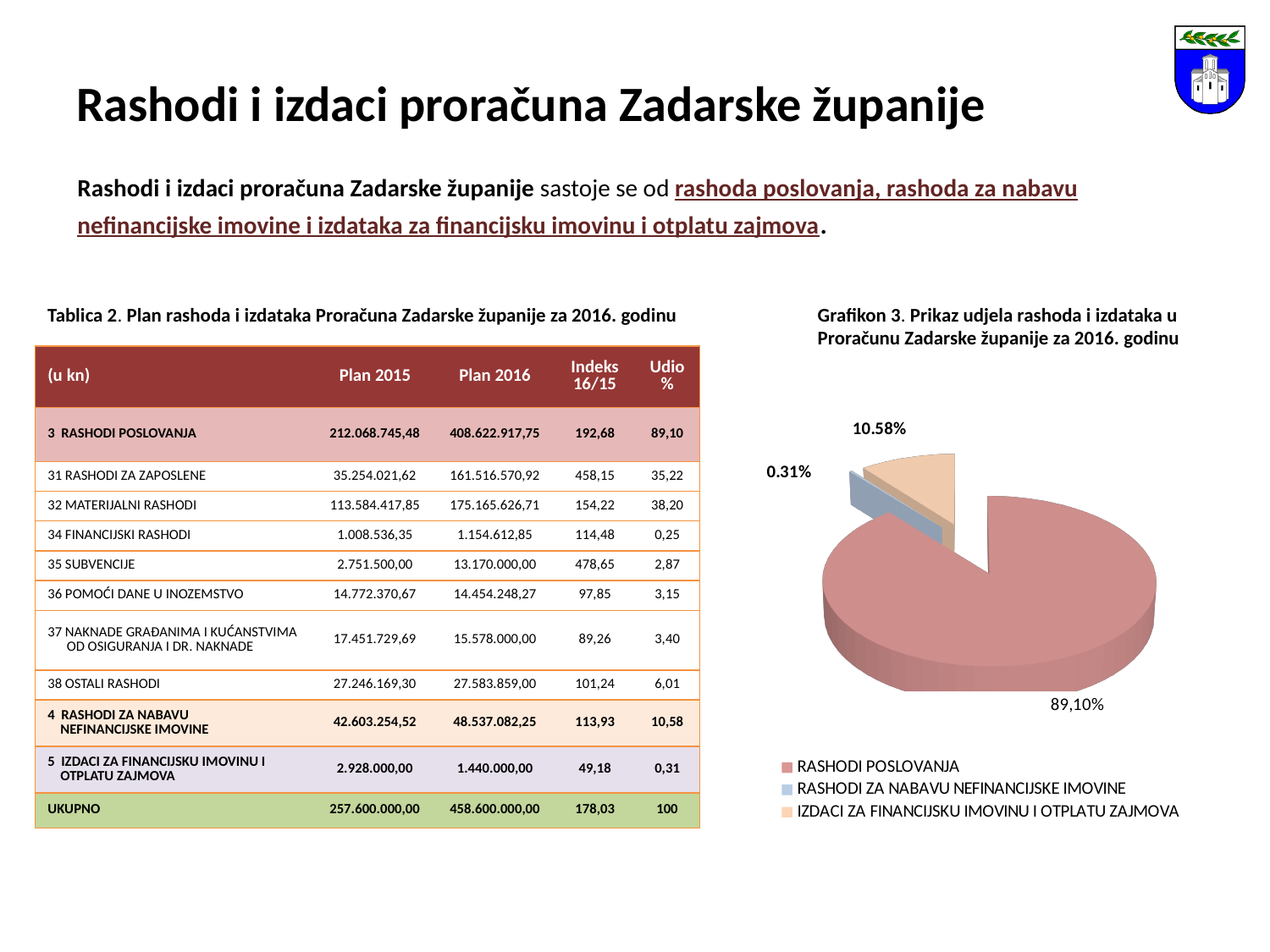
What is the largest percentage label shown on the pie chart in Grafikon 3? 89,10% How many entries does the legend of Grafikon 3 list? 3 Which category has the largest slice in Grafikon 3? RASHODI POSLOVANJA What is the title of the pie chart on the slide? Grafikon 3. Prikaz udjela rashoda i izdataka u Proračunu Zadarske županije za 2016. godinu In Grafikon 3, which is larger: the slice labelled 10.58% or the slice labelled 0.31%? The slice labelled 10.58% What type of chart is Grafikon 3 on the slide? Pie chart What is the smallest percentage label shown on the pie chart in Grafikon 3? 0.31% In Grafikon 3, what share of the pie does RASHODI POSLOVANJA have? 89,10% Which legend entry is listed first in Grafikon 3? RASHODI POSLOVANJA How many slices does the pie chart in Grafikon 3 have? 3